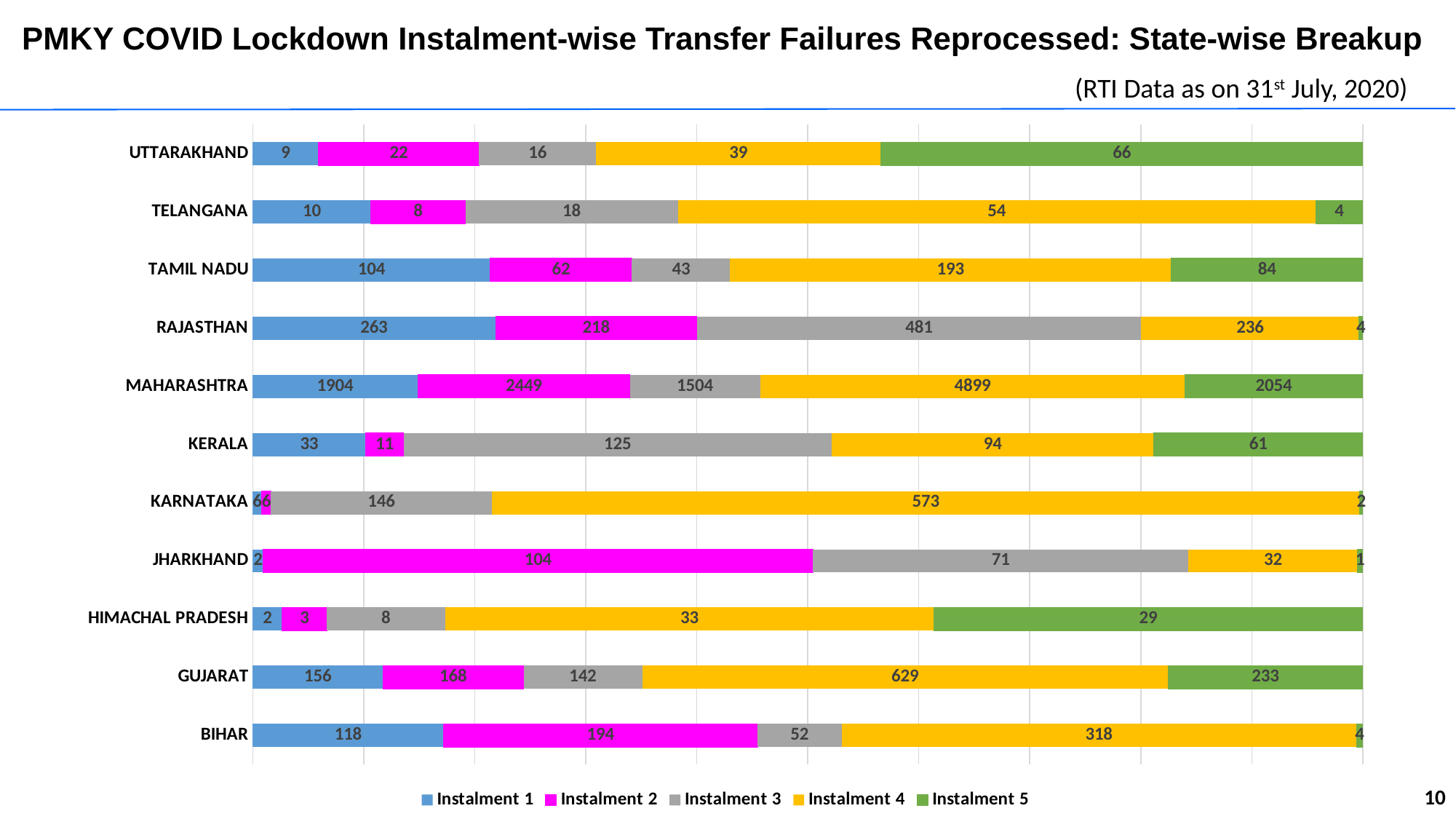
What is the Instalment 2 value for Jharkhand? 104 What is the Instalment 3 value for Rajasthan? 481 What type of chart is shown on the slide? Stacked bar chart What is the Instalment 5 value for Gujarat? 233 How many series does the legend list? 5 What is the difference between Instalment 4 and Instalment 2 for Maharashtra? 2450 Which is larger for Bihar: Instalment 1 or Instalment 2? Instalment 2 How many states are shown on the chart? 11 For Rajasthan, which instalment has the highest value? Instalment 3 What is the Instalment 4 value for Maharashtra? 4899 What is the total of all five instalments for Gujarat? 1328 Which state has the highest Instalment 4 value? Maharashtra